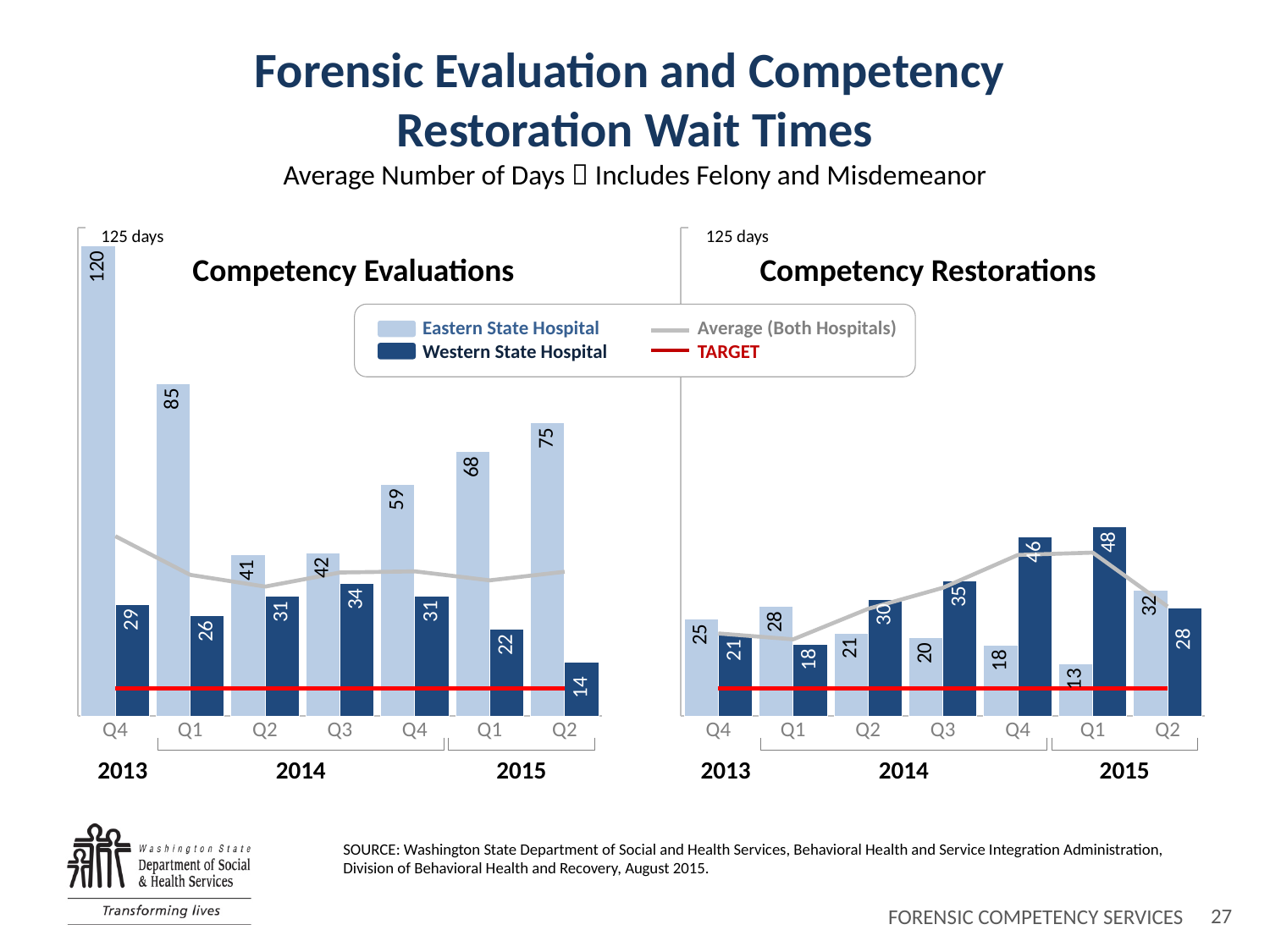
In the Competency Restorations chart, what is the value for Western State Hospital in Q1 2015? 48 In the Competency Evaluations chart, what is the difference between the Eastern State Hospital and Western State Hospital values in Q2 2015? 61 In the Competency Restorations chart, what is the value for Eastern State Hospital in Q2 2015? 32 In the Competency Evaluations chart, what is the value for Western State Hospital in Q2 2015? 14 In the Competency Restorations chart, which quarter has the lowest Eastern State Hospital value? Q1 2015 In the Competency Evaluations chart, what is the value for Eastern State Hospital in Q4 2013? 120 In the Competency Restorations chart, does the Western State Hospital value rise or fall from Q1 2014 to Q1 2015? Rise What kind of chart is the Competency Restorations chart? Bar chart with a line In the Competency Evaluations chart, which quarter has the highest Eastern State Hospital value? Q4 2013 In the Competency Restorations chart, which is larger in Q4 2014: Eastern State Hospital or Western State Hospital? Western State Hospital How many entries does the legend list? 4 In the Competency Evaluations chart, how many quarters are shown on the x axis? 7